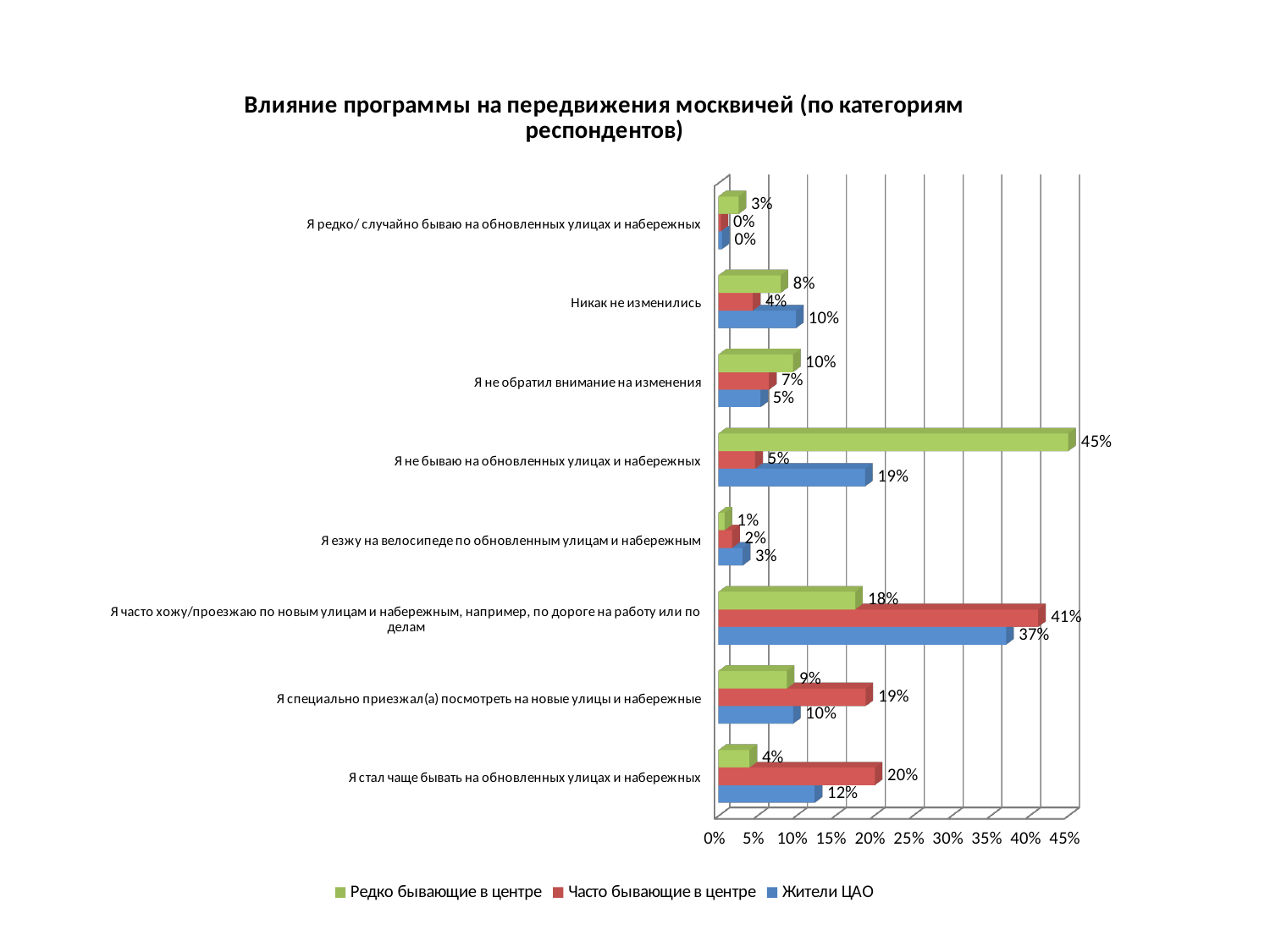
What is the difference between "Часто бывающие в центре" and "Жители ЦАО" in the category "Я специально приезжал(а) посмотреть на новые улицы и набережные"? 9% How many categories are shown on the chart? 8 What kind of chart is shown on the slide? bar chart Which category has the highest value for the series "Жители ЦАО"? Я часто хожу/проезжаю по новым улицам и набережным, например, по дороге на работу или по делам What is the value for "Часто бывающие в центре" in the category "Я часто хожу/проезжаю по новым улицам и набережным, например, по дороге на работу или по делам"? 41% What is the value for "Редко бывающие в центре" in the category "Я не бываю на обновленных улицах и набережных"? 45% Which category has the lowest value for the series "Редко бывающие в центре"? Я езжу на велосипеде по обновленным улицам и набережным In the category "Никак не изменились", which series has the larger value: "Редко бывающие в центре" or "Жители ЦАО"? Жители ЦАО What is the value for "Жители ЦАО" in the category "Я стал чаще бывать на обновленных улицах и набережных"? 12% What is the difference between "Редко бывающие в центре" and "Жители ЦАО" in the category "Я не бываю на обновленных улицах и набережных"? 26% How many series does the legend list? 3 What colour represents the series "Часто бывающие в центре"? red